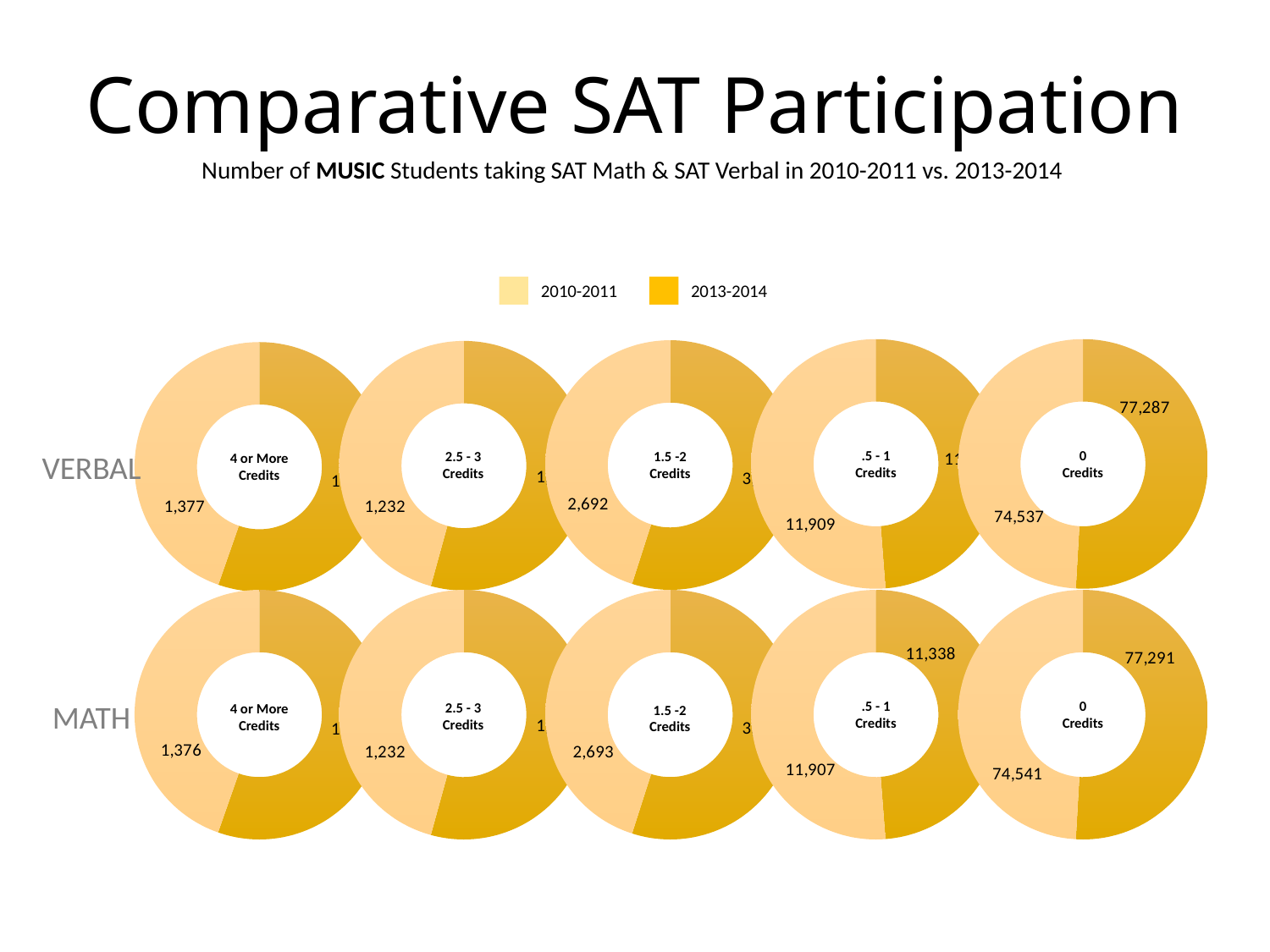
In the VERBAL row, what is the 2013-2014 value on the '0 Credits' donut chart? 77,287 In the VERBAL row, what is the 2010-2011 value on the '4 or More Credits' donut chart? 1,377 In the MATH row, what is the 2010-2011 value on the '.5 - 1 Credits' donut chart? 11,907 In the MATH row, what is the 2010-2011 value on the '0 Credits' donut chart? 74,541 In the VERBAL row, what is the 2010-2011 value on the '1.5 -2 Credits' donut chart? 2,692 What kind of chart is used on this slide? Donut chart On the VERBAL '0 Credits' donut chart, which series has the larger value, 2010-2011 or 2013-2014? 2013-2014 On the MATH '0 Credits' donut chart, what is the difference between the 2013-2014 value and the 2010-2011 value? 2,750 On the MATH '.5 - 1 Credits' donut chart, which series has the larger value, 2010-2011 or 2013-2014? 2010-2011 In the MATH row, what is the 2013-2014 value on the '.5 - 1 Credits' donut chart? 11,338 How many series does the legend list? 2 How many donut charts are shown in the MATH row? 5